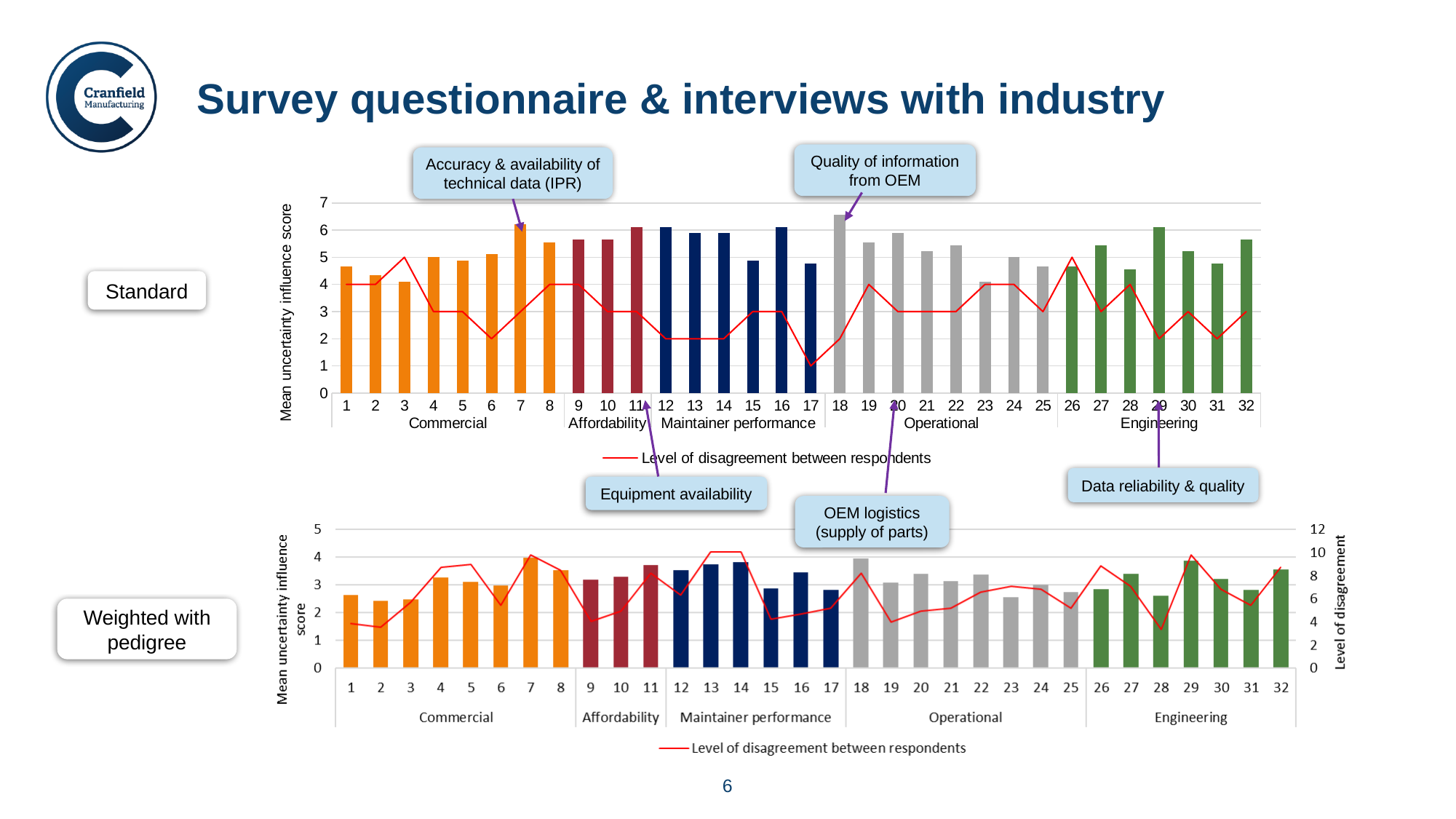
In the Standard chart, is the bar for item 3 greater or less than 5? less In the Standard chart, is the bar for item 18 greater or less than 6? greater In the Standard chart, which has the larger bar, item 7 or item 3? Item 7 In the Weighted with pedigree chart, is the bar for item 1 greater or less than 3? less In the Weighted with pedigree chart, which has the larger bar, item 7 or item 2? Item 7 How many category groups (such as Commercial and Engineering) are shown on the x axis of the Weighted with pedigree chart? 5 What is the legend entry shown below the Weighted with pedigree chart? Level of disagreement between respondents How many numbered items are plotted along the x axis of the Standard chart? 32 In the Standard chart, which numbered item has the highest mean uncertainty influence score? 18 What kind of chart is the Standard chart? Bar chart with a line